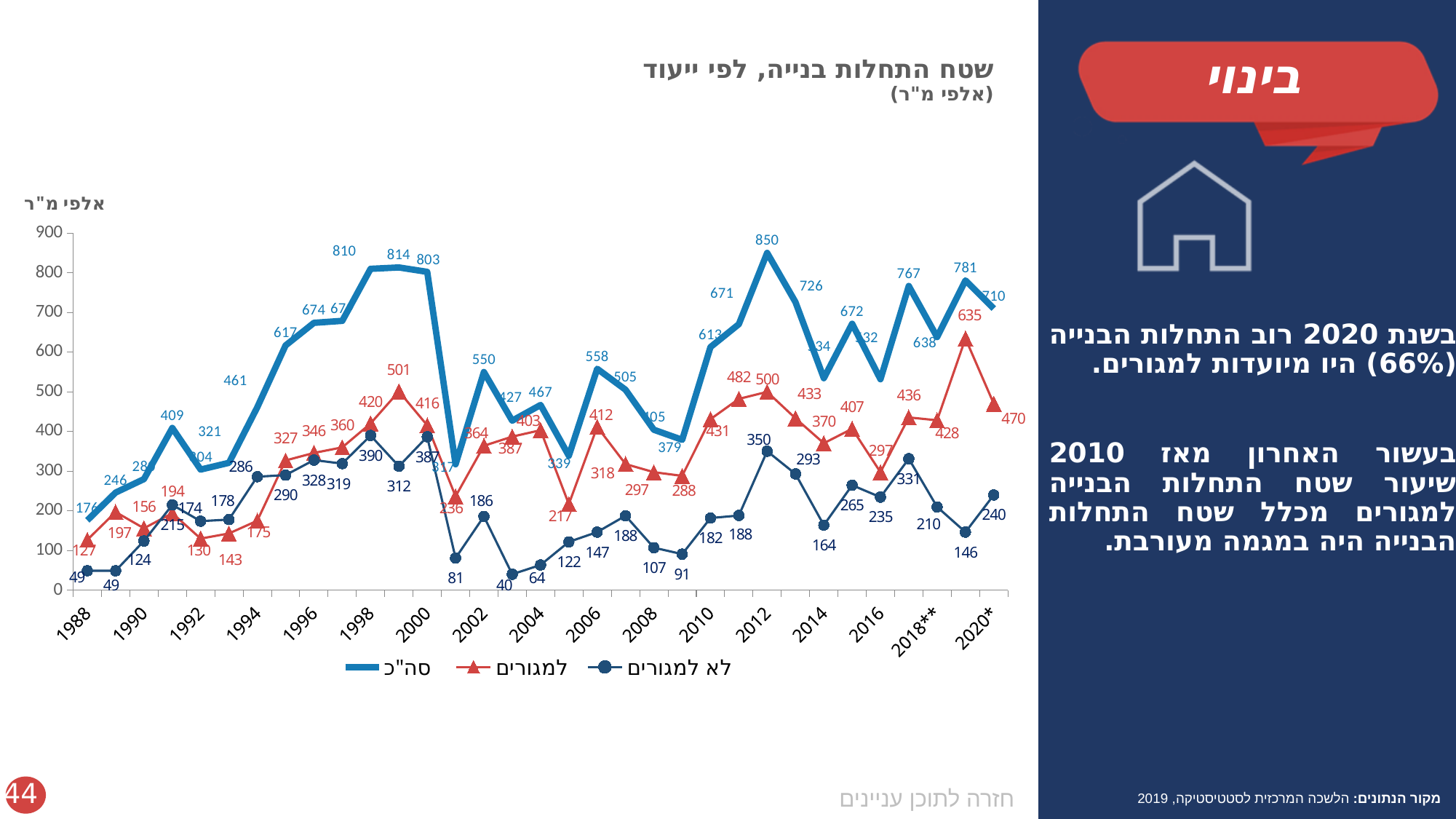
What unit is shown on the y-axis of the chart? אלפי מ"ר What is the lowest value of the לא למגורים series? 40 How many series does the chart legend list? 3 What is the value of the סה"כ series in 2012? 850 What kind of chart is shown on the slide? line chart Is the value of the סה"כ series in 2010 greater or less than 600? greater What is the value of the לא למגורים series in 2020*? 240 In 2012, which is larger: the למגורים value or the לא למגורים value? למגורים What is the highest value reached by the למגורים series? 635 What is the highest value reached by the סה"כ series, and in which year? 850, in 2012 In 2020*, what is the difference between the למגורים value and the לא למגורים value? 230 What is the value of the למגורים series in 2020*? 470